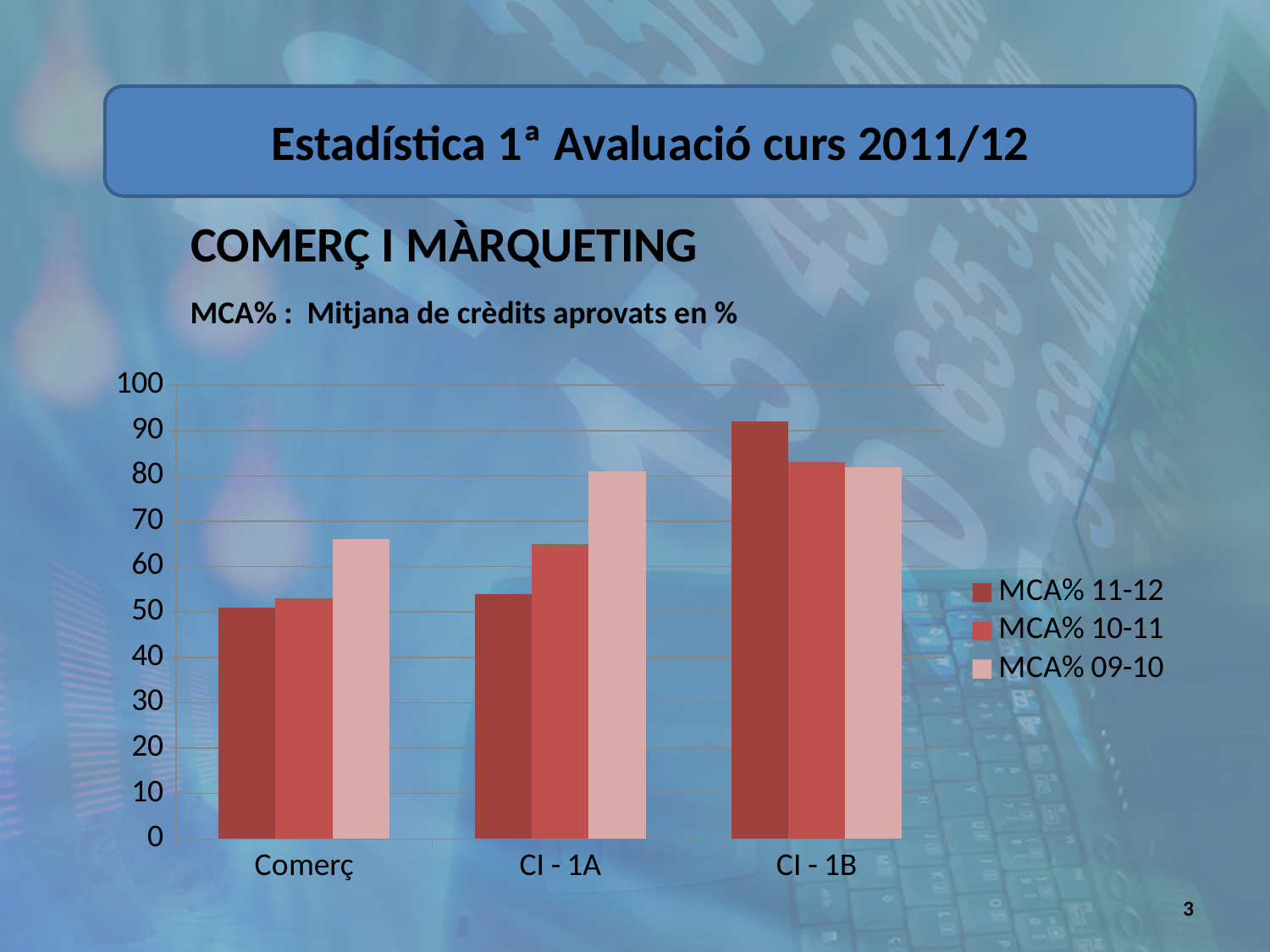
Is the MCA% 09-10 value for Comerç greater or less than 60? greater Which category has the lowest MCA% 09-10 value? Comerç What are the three series listed in the chart legend? MCA% 11-12, MCA% 10-11, MCA% 09-10 Is the MCA% 10-11 value for CI - 1A greater or less than 60? greater Which category has the highest MCA% 11-12 value? CI - 1B How many series does the chart legend list? 3 What kind of chart is shown on the slide? bar chart Is the MCA% 11-12 value for CI - 1A greater or less than 60? less For CI - 1B, which is larger: the MCA% 11-12 value or the MCA% 10-11 value? MCA% 11-12 Do the MCA% 11-12 values rise or fall moving from Comerç to CI - 1A to CI - 1B? rise How many categories are shown on the x axis of the chart? 3